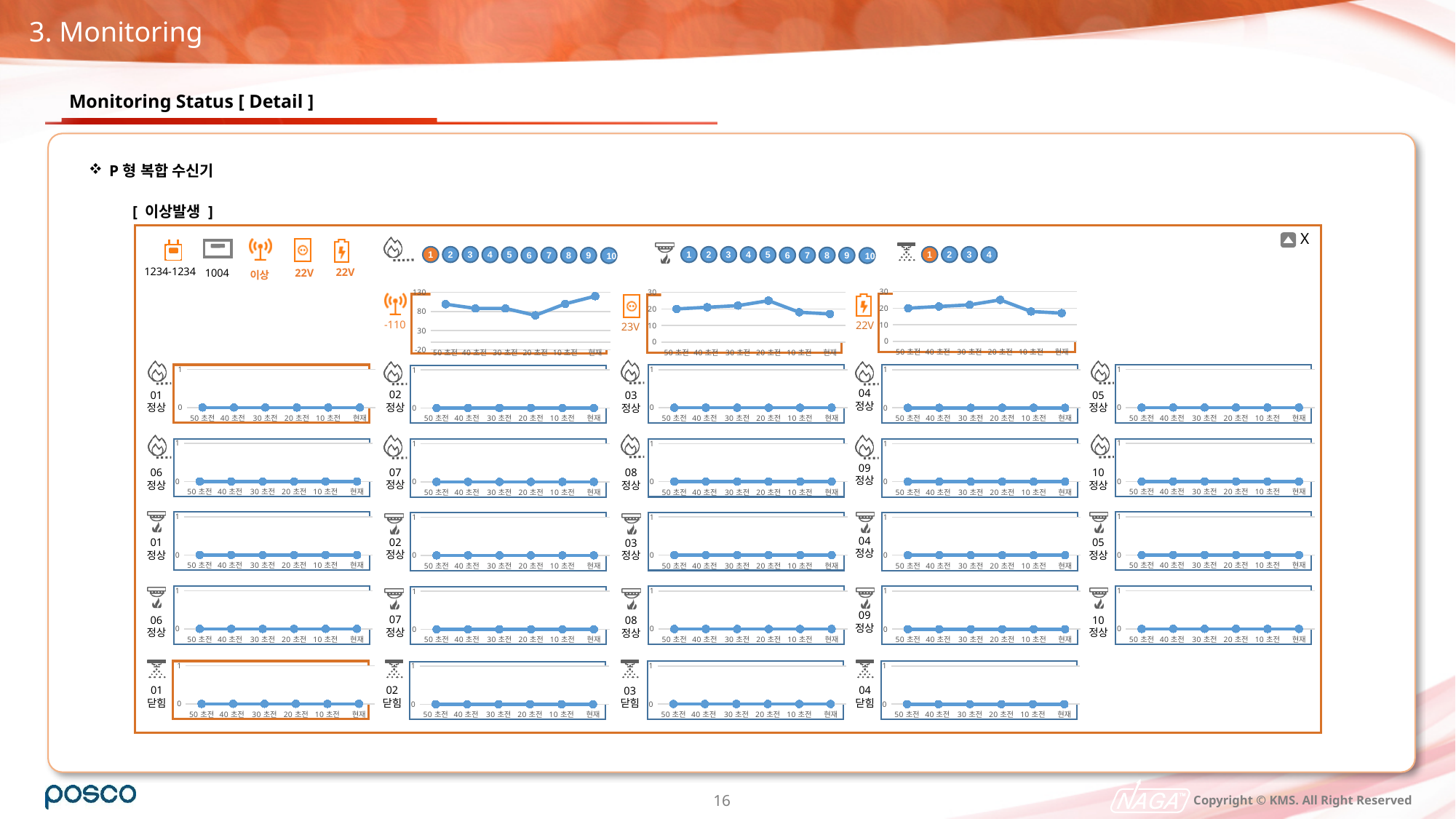
In the top-left line chart (next to the -110 label), is the value at 현재 greater or less than 80? greater In the top-right line chart (next to the 22V label), at which x-axis label is the value highest? 20 초전 In the top-left line chart (next to the -110 label), how many data points are plotted? 6 In the top-left line chart (next to the -110 label), at which x-axis label is the value highest? 현재 In the top-middle line chart (next to the 23V label), at which x-axis label is the value highest? 20 초전 What kind of chart is the top-left chart next to the signal icon labelled -110? line chart What is the first x-axis label shown on the small chart labelled 01 닫힘 in the bottom row? 50 초전 In the top-left line chart (next to the -110 label), at which x-axis label is the value lowest? 20 초전 In the small chart labelled 01 정상 in the first row of the grid, do the values rise, fall, or stay flat from 50 초전 to 현재? stay flat In the top-middle line chart (next to the 23V label), is the value at 20 초전 greater or less than 20? greater In the top-right line chart (next to the 22V label), is the value at 50 초전 greater or less than 10? greater What is the highest y-axis tick shown on the top-left line chart (next to the -110 label)? 130